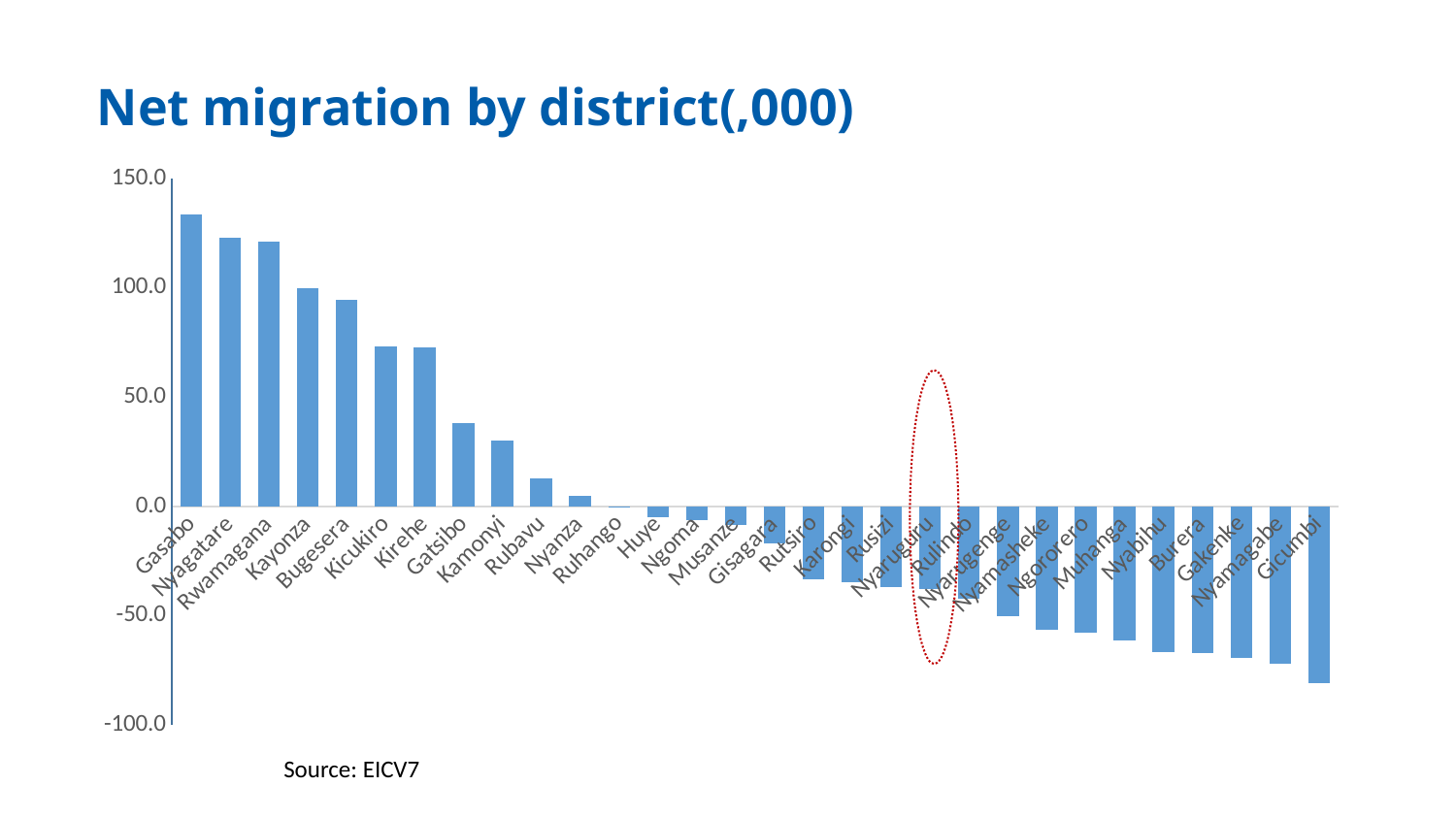
What kind of chart is shown on the slide? bar chart Is the value for Rulindo greater or less than -50.0? greater How many districts are shown on the chart? 30 Is the value for Kicukiro greater or less than 50.0? greater Which has the larger net migration, Gasabo or Nyagatare? Gasabo Which district has the lowest net migration? Gicumbi Do the values rise or fall moving from left to right along the x axis? fall Is the value for Bugesera greater or less than 100.0? less Which district has the highest net migration? Gasabo